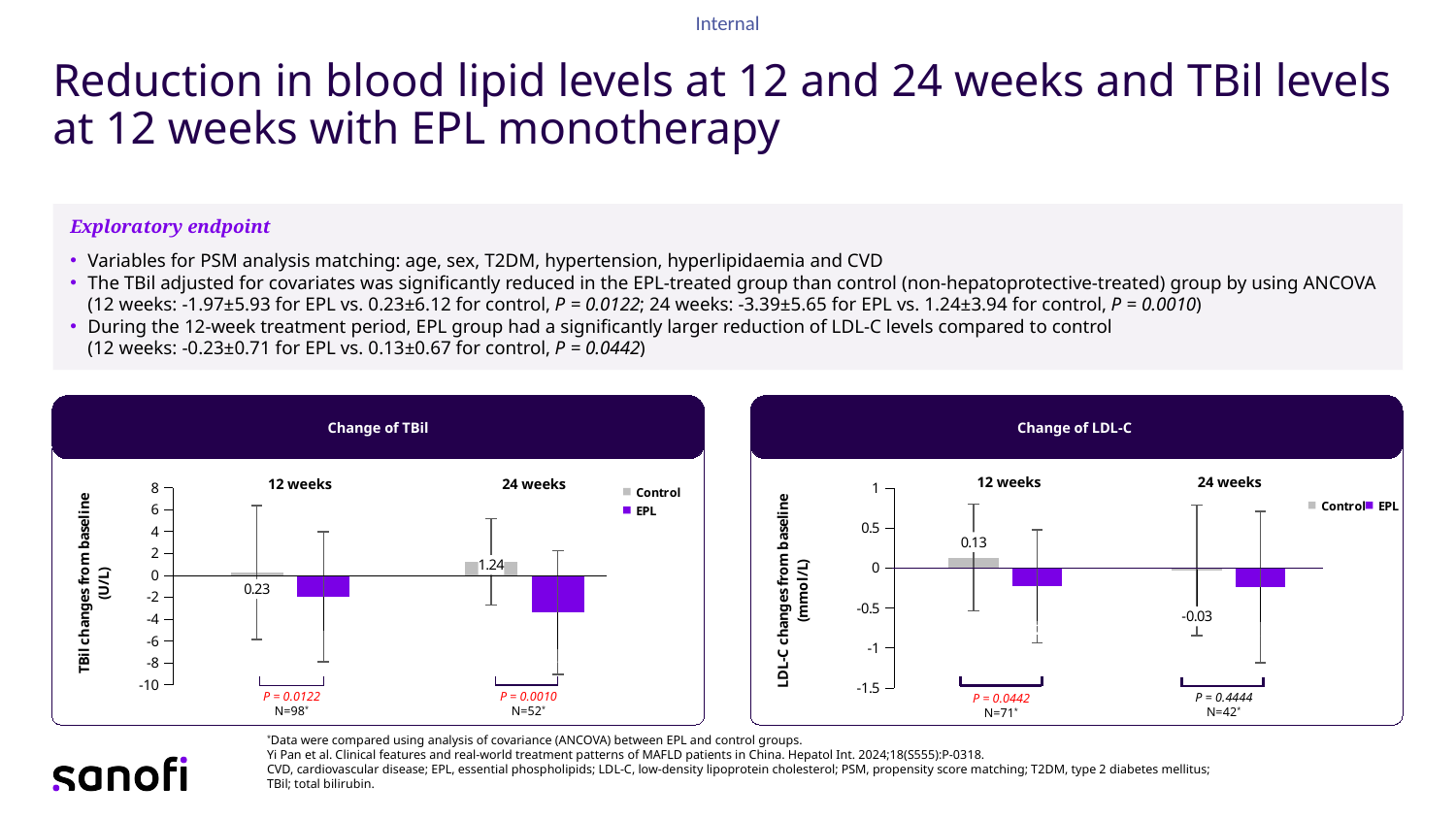
What kind of chart is the Change of LDL-C chart? Bar chart In the Change of TBil chart, which is larger for Control: the value at 12 weeks or at 24 weeks? 24 weeks In the Change of LDL-C chart, is the value for EPL at 12 weeks greater or less than 0? less In the Change of TBil chart, how many series does the legend list? 2 In the Change of LDL-C chart, what is the value for Control at 12 weeks? 0.13 In the Change of TBil chart, what is the value for Control at 24 weeks? 1.24 In the Change of TBil chart, is the value for EPL at 12 weeks greater or less than 0? less In the Change of LDL-C chart, what P value is shown for the 12 weeks comparison? P = 0.0442 In the Change of TBil chart, what is the difference between the Control values at 24 weeks and 12 weeks? 1.01 In the Change of TBil chart, what is the value for Control at 12 weeks? 0.23 In the Change of LDL-C chart, what is the value for Control at 24 weeks? -0.03 In the Change of TBil chart, is the value for EPL at 24 weeks greater or less than -2? less